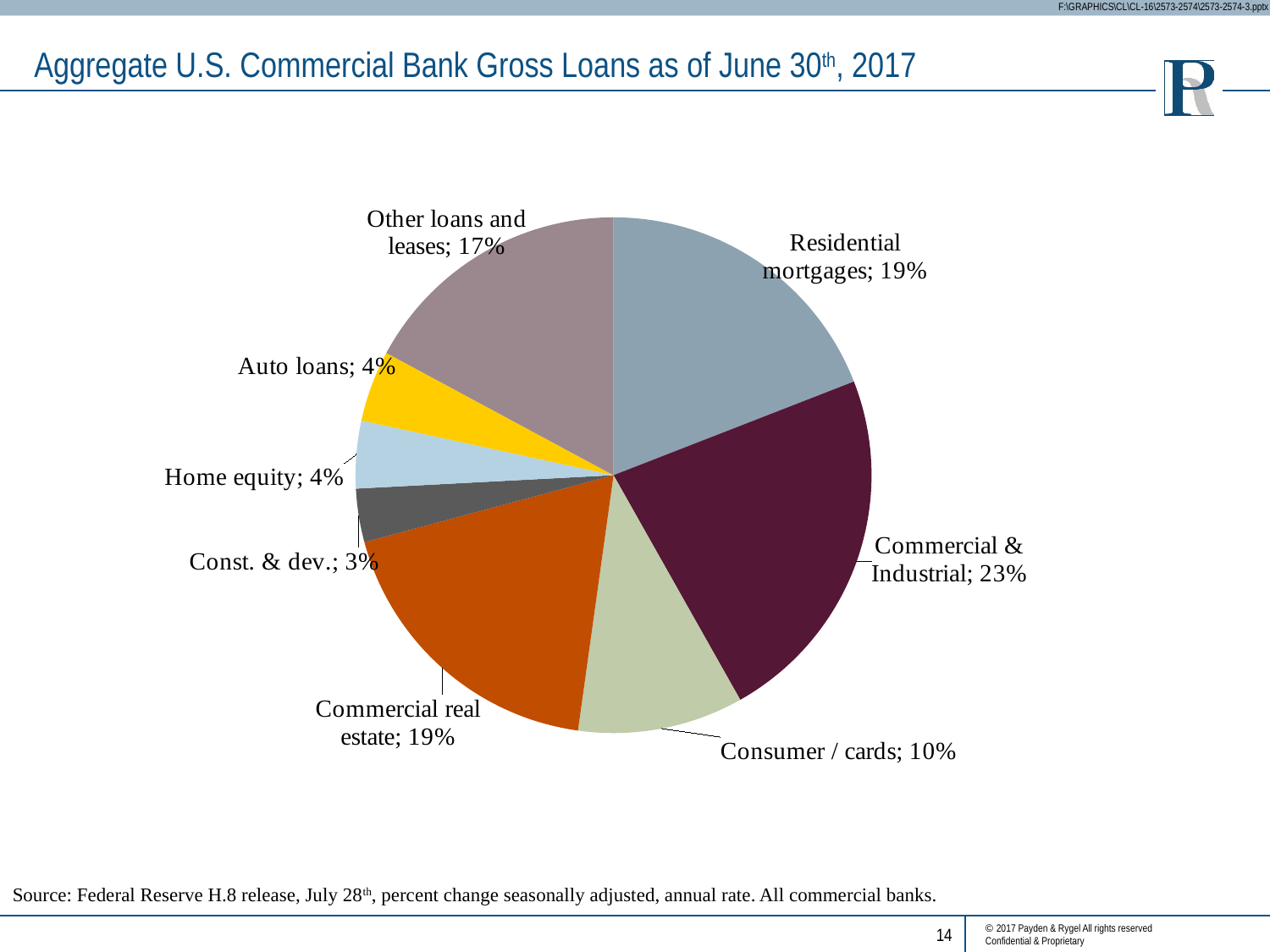
What is the combined share of Residential mortgages and Commercial real estate? 38% How many slices does the pie chart have? 8 Which loan category has the largest share of the pie? Commercial & Industrial What type of chart is shown on the slide? pie chart Which is larger, Other loans and leases or Residential mortgages? Residential mortgages What is the difference in percentage points between Commercial & Industrial and Consumer / cards? 13 What share of gross loans is Consumer / cards? 10% Which loan category has the smallest share of the pie? Const. & dev. What share of gross loans is Commercial & Industrial? 23% What share of gross loans is Const. & dev.? 3% What is the title of the slide? Aggregate U.S. Commercial Bank Gross Loans as of June 30th, 2017 What share of gross loans is Other loans and leases? 17%